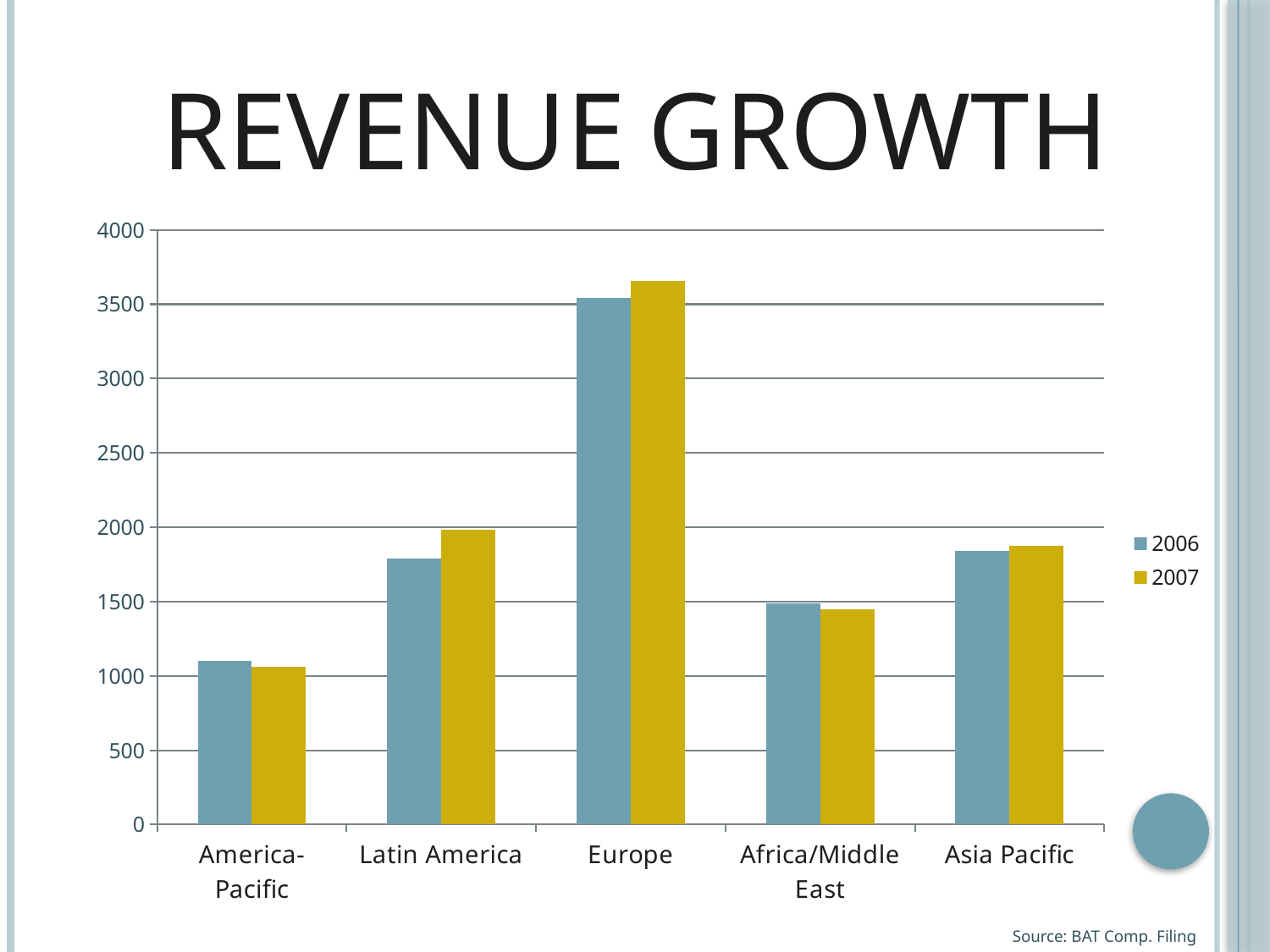
Which region has the lowest revenue in 2006? America-Pacific What kind of chart is shown on the slide? bar chart Is the 2006 value for America-Pacific greater or less than 1000? greater How many series does the legend list? 2 Which region has the highest revenue in 2007? Europe For Africa/Middle East, which year has the larger value, 2006 or 2007? 2006 For Latin America, which year has the larger value, 2006 or 2007? 2007 How many regions are shown on the x axis? 5 Is the 2006 value for Asia Pacific greater or less than 2000? less Is the 2007 value for Europe greater or less than 3500? greater What is the title of the chart? REVENUE GROWTH